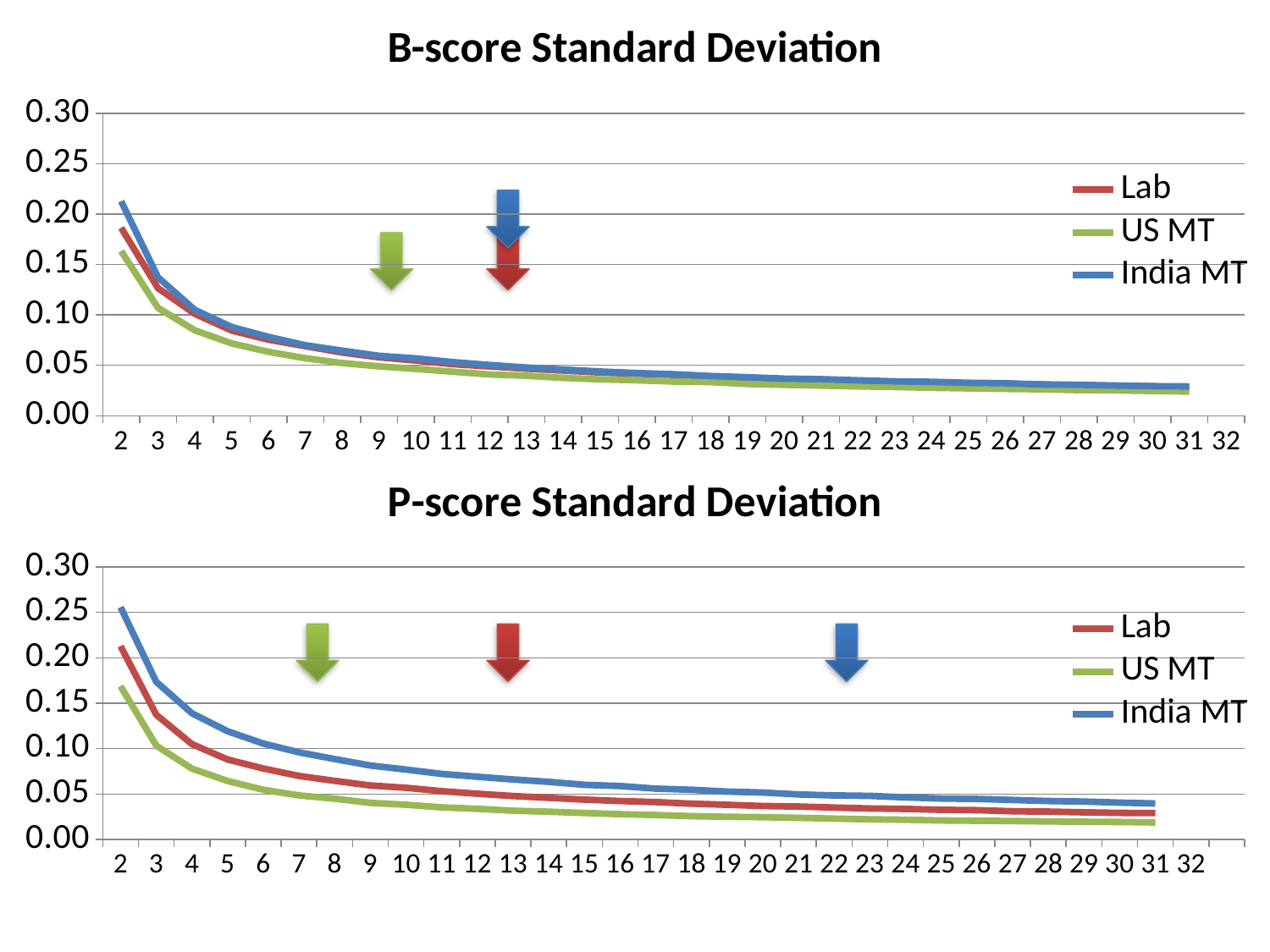
In the B-score Standard Deviation chart, do the values rise or fall as the x axis increases? fall What kind of chart is the B-score Standard Deviation chart? line chart In the P-score Standard Deviation chart, is the value for India MT at x = 31 greater or less than 0.05? less In the B-score Standard Deviation chart, which series has the highest value at x = 2? India MT In the P-score Standard Deviation chart, is the value for US MT at x = 2 greater or less than 0.20? less In the P-score Standard Deviation chart, which series has the highest value at x = 2? India MT In the B-score Standard Deviation chart, is the value for India MT at x = 2 greater or less than 0.20? greater In the P-score Standard Deviation chart, do the values rise or fall as the x axis increases? fall How many series does the legend of the P-score Standard Deviation chart list? 3 In the P-score Standard Deviation chart, which is larger at x = 10: India MT or US MT? India MT Which series is drawn in green in the B-score Standard Deviation chart? US MT In the B-score Standard Deviation chart, which series has the lowest value at x = 2? US MT